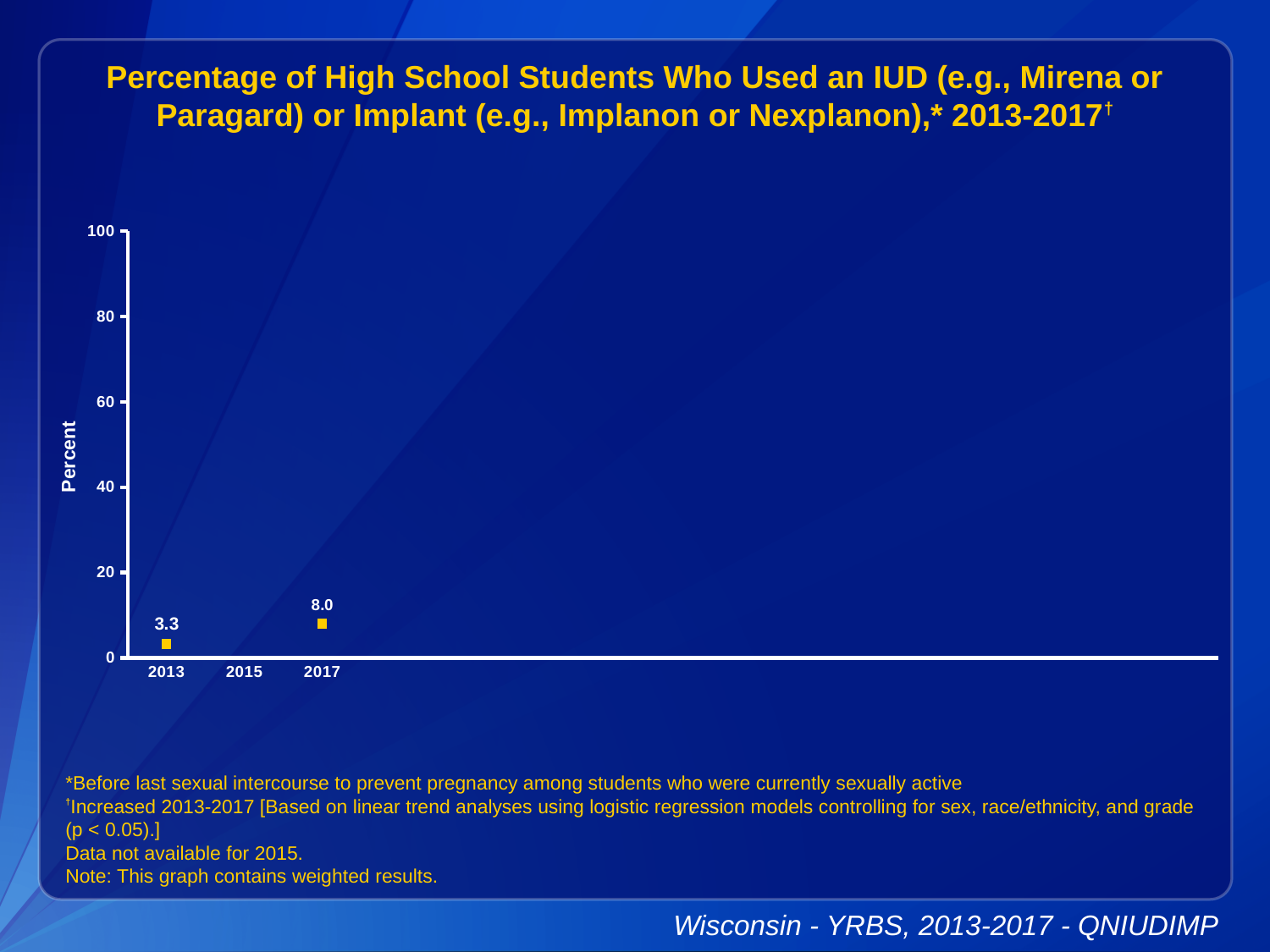
How many data points are plotted on the chart? 2 Is the value for 2017 greater or less than 20? less Which year has the highest value? 2017 What is the label on the y axis? Percent What is the value for 2017? 8.0 Do the values rise or fall from 2013 to 2017? rise Which is larger, the value for 2013 or the value for 2017? 2017 What is the value for 2013? 3.3 Which year has the lowest plotted value? 2013 Which year on the x axis has no data plotted? 2015 What is the difference between the 2017 and 2013 values? 4.7 What is the maximum value shown on the y axis? 100